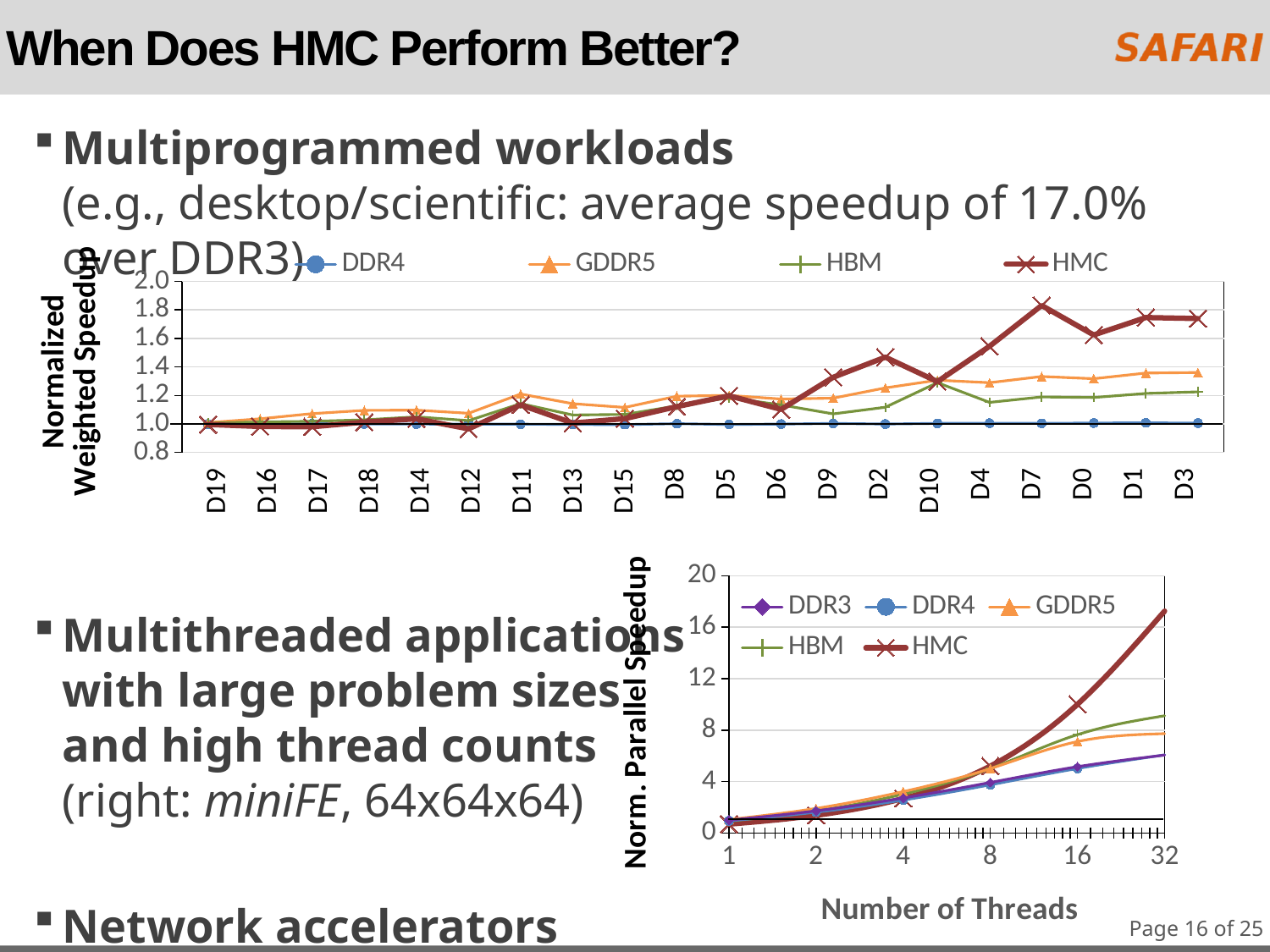
On the top chart (Normalized Weighted Speedup), which is larger at D0, HMC or GDDR5? HMC On the bottom-right chart (Norm. Parallel Speedup), is the HMC value at 32 threads greater or less than 16? greater On the top chart (Normalized Weighted Speedup), is the HMC value for D7 greater or less than 1.6? greater On the bottom-right chart (Norm. Parallel Speedup), how many thread counts are marked on the x axis? 6 What is the x-axis title of the bottom-right chart? Number of Threads On the bottom-right chart (Norm. Parallel Speedup), how many series does the legend list? 5 On the top chart (Normalized Weighted Speedup), at which workload does HMC reach its highest value? D7 On the top chart (Normalized Weighted Speedup), does the HMC series generally rise or fall from left to right along the x axis? Rise What kind of chart is the top chart (Normalized Weighted Speedup)? Line chart On the top chart (Normalized Weighted Speedup), which series has the highest value at D3? HMC On the top chart (Normalized Weighted Speedup), how many workload categories are shown on the x axis? 20 On the top chart (Normalized Weighted Speedup), how many series does the legend list? 4